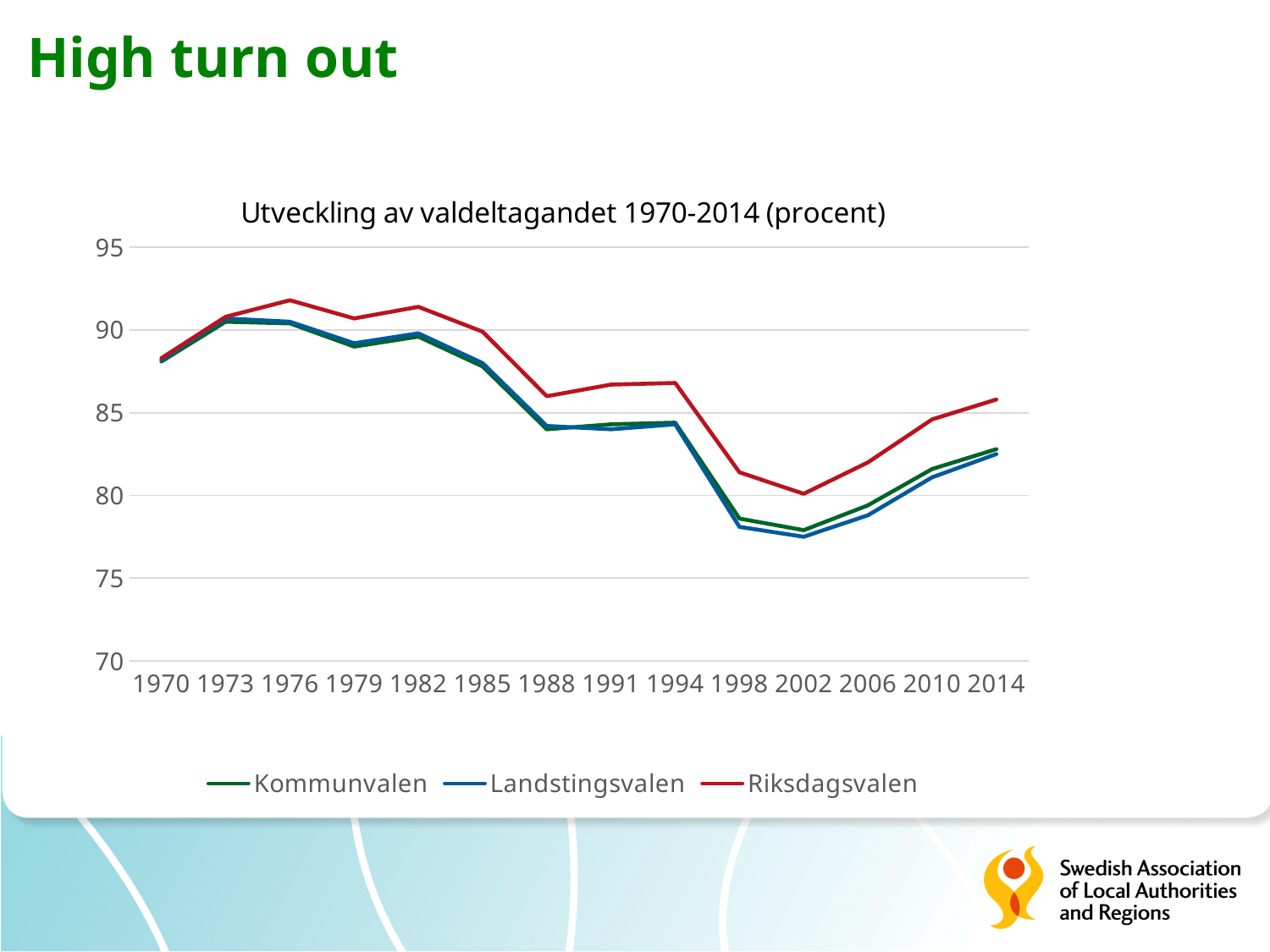
How many election years are plotted along the x axis? 14 Does the Riksdagsvalen line rise or fall between 2002 and 2014? rise Which colour is used for the Riksdagsvalen line? red How many series does the legend list? 3 What kind of chart is shown on the slide? line chart Is the value for Landstingsvalen in 2002 greater or less than 80? less In which year is the Landstingsvalen value lowest? 2002 Is the value for Riksdagsvalen in 1976 greater or less than 90? greater In which year is the Riksdagsvalen value lowest? 2002 What is the title of the chart? Utveckling av valdeltagandet 1970-2014 (procent) Which series has the higher value in 2002, Riksdagsvalen or Landstingsvalen? Riksdagsvalen Is the value for Riksdagsvalen in 2002 greater or less than 85? less